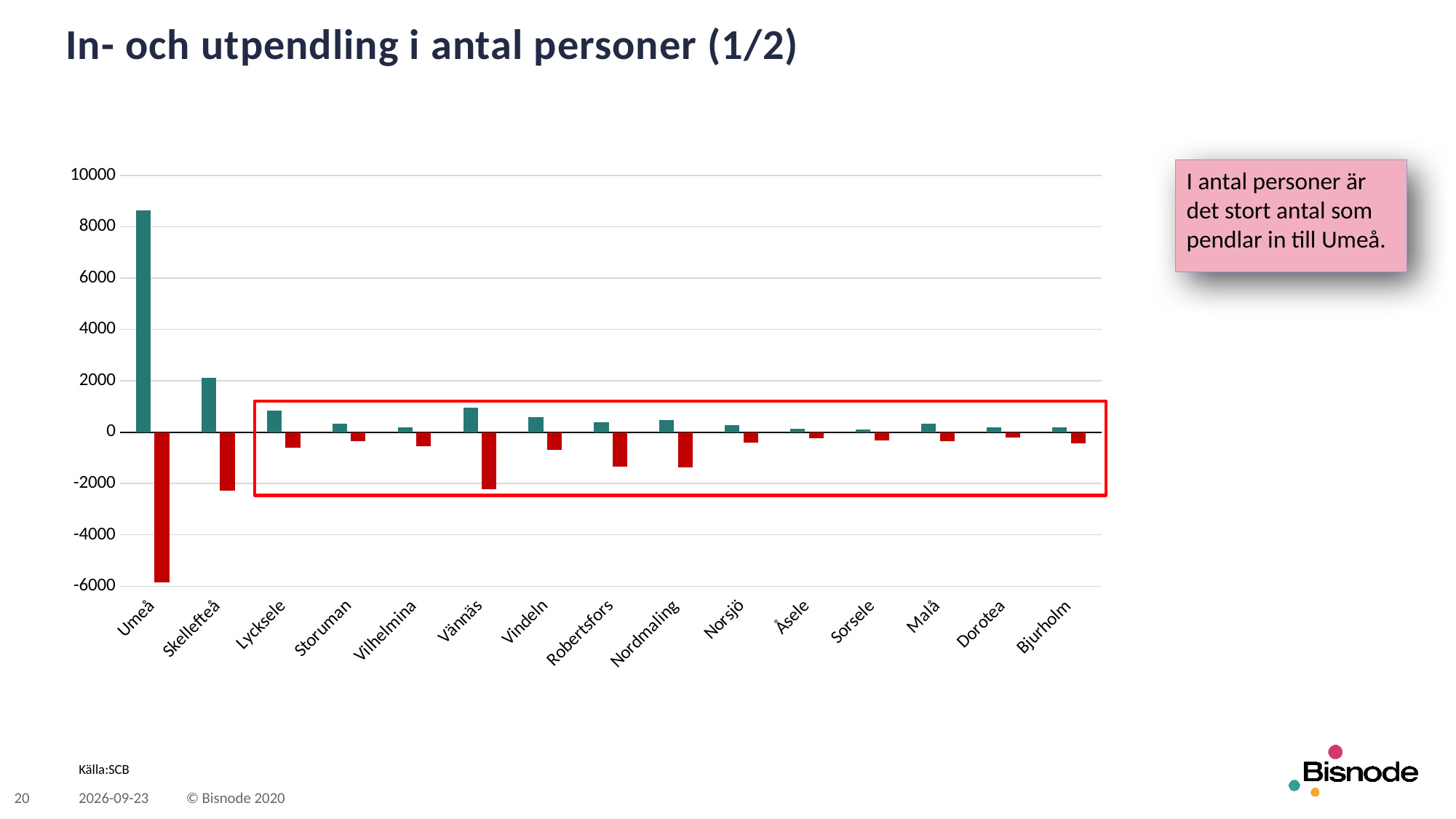
Is the teal bar for Umeå greater or less than 8000? greater Which has the larger teal bar, Vännäs or Storuman? Vännäs What kind of chart is shown on the slide? bar chart What source is cited below the chart? Källa:SCB Which municipality has the lowest red (negative) bar? Umeå What is the title of the chart on the slide? In- och utpendling i antal personer (1/2) Is the teal bar for Lycksele greater or less than 2000? less How many municipalities are shown on the x axis of the chart? 15 Which municipality has the tallest teal (positive) bar? Umeå Is the red bar for Skellefteå greater or less than -2000? less How many bars are plotted for each municipality in the chart? 2